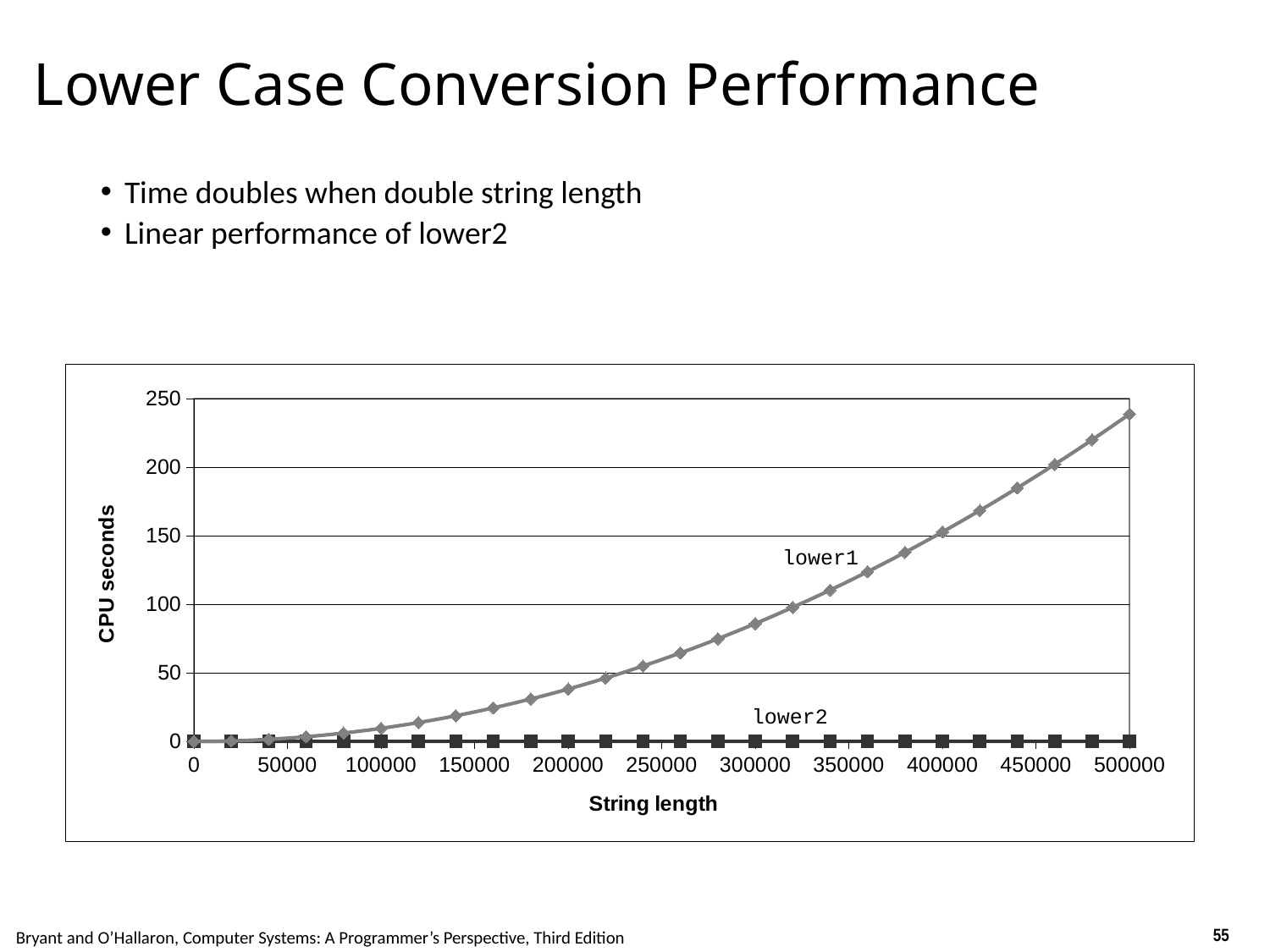
At a string length of 500000, which series has the larger value, lower1 or lower2? lower1 Does the lower1 series rise or fall as string length increases? rise Is the value of lower1 at a string length of 300000 greater or less than 100? less Is the value of lower2 at a string length of 500000 greater or less than 50? less Is the value of lower1 at a string length of 500000 greater or less than 200? greater Which series has the highest value at a string length of 400000? lower1 Which series has the lowest value at a string length of 200000? lower2 What kind of chart is shown on the slide? line chart What is the label of the y axis of the chart? CPU seconds How many series are plotted on the chart? 2 What is the label of the x axis of the chart? String length